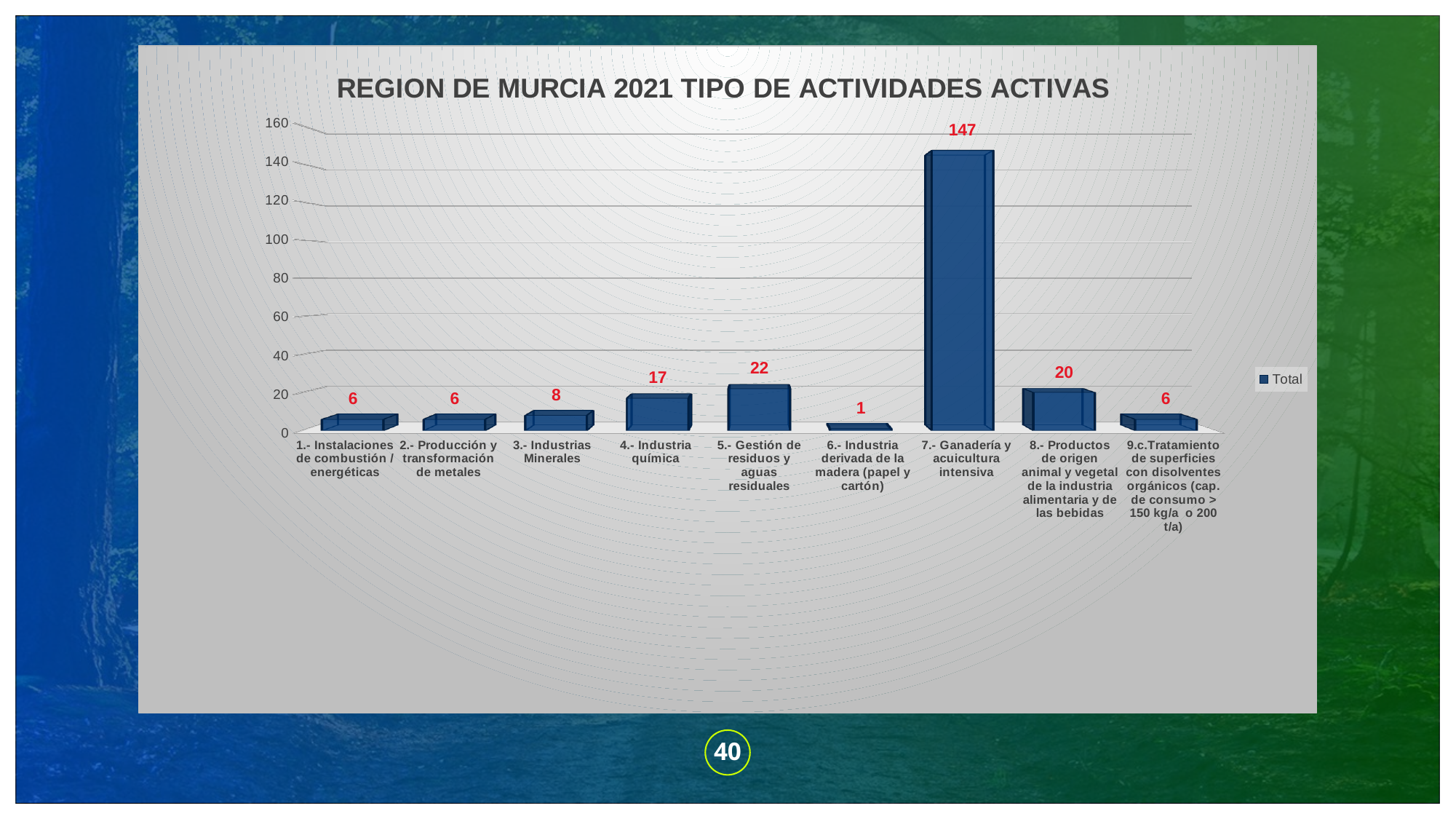
How many series does the legend list? 1 What kind of chart is shown on the slide? bar chart What is the difference between the values for 7.- Ganadería y acuicultura intensiva and 8.- Productos de origen animal y vegetal de la industria alimentaria y de las bebidas? 127 What is the value for 5.- Gestión de residuos y aguas residuales? 22 Is the value for 7.- Ganadería y acuicultura intensiva greater or less than 140? greater What is the value for 4.- Industria química? 17 Which category has the lowest value? 6.- Industria derivada de la madera (papel y cartón) What is the value for 7.- Ganadería y acuicultura intensiva? 147 Which category has the highest value? 7.- Ganadería y acuicultura intensiva What is the value for 6.- Industria derivada de la madera (papel y cartón)? 1 How many categories are shown on the x axis? 9 Which is larger, the value for 5.- Gestión de residuos y aguas residuales or the value for 4.- Industria química? 5.- Gestión de residuos y aguas residuales